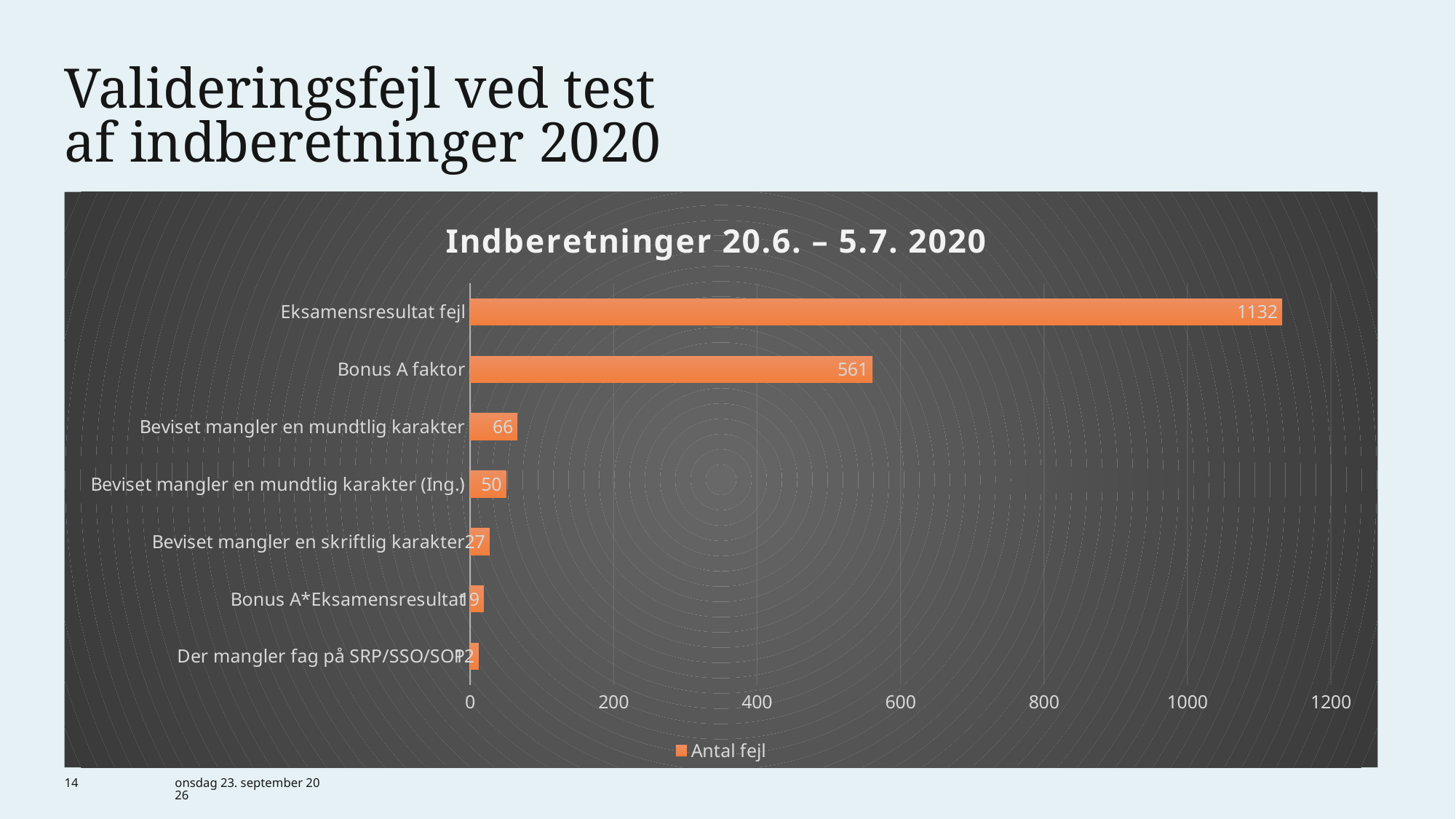
Which category has the lowest value? Der mangler fag på SRP/SSO/SOP Is the value for Bonus A faktor greater or less than 600? less Which is larger, the value for Beviset mangler en mundtlig karakter or Beviset mangler en mundtlig karakter (Ing.)? Beviset mangler en mundtlig karakter What type of chart is shown on the slide? bar chart What is the value for Beviset mangler en mundtlig karakter? 66 What is the value for Beviset mangler en mundtlig karakter (Ing.)? 50 What is the title of the chart? Indberetninger 20.6. – 5.7. 2020 What is the value for Eksamensresultat fejl? 1132 What is the value for Bonus A faktor? 561 Which category has the highest value? Eksamensresultat fejl How many categories are shown in the chart? 7 What is the difference between the values for Eksamensresultat fejl and Bonus A faktor? 571